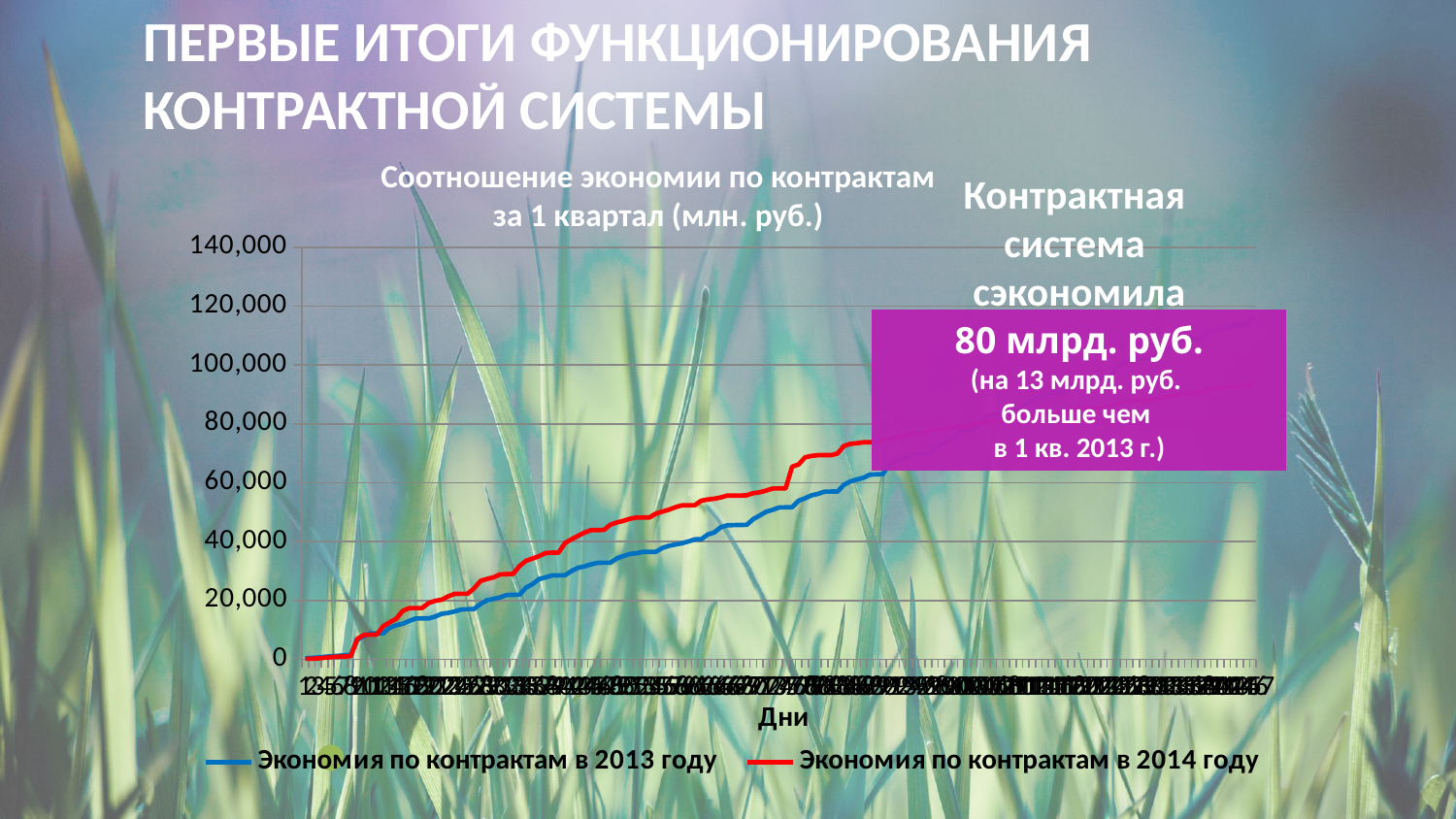
Is the final value of the series "Экономия по контрактам в 2014 году" greater or less than 100,000? less What is the label of the x axis? Дни What is the title of the chart? Соотношение экономии по контрактам за 1 квартал (млн. руб.) What kind of chart is shown on the slide? line chart Do the values of the series "Экономия по контрактам в 2013 году" rise or fall along the x axis? rise Is the final value of the series "Экономия по контрактам в 2013 году" greater or less than 40,000? greater Do the values of the series "Экономия по контрактам в 2014 году" rise or fall along the x axis? rise How many series does the chart legend list? 2 Is the final value of the series "Экономия по контрактам в 2014 году" greater or less than 60,000? greater